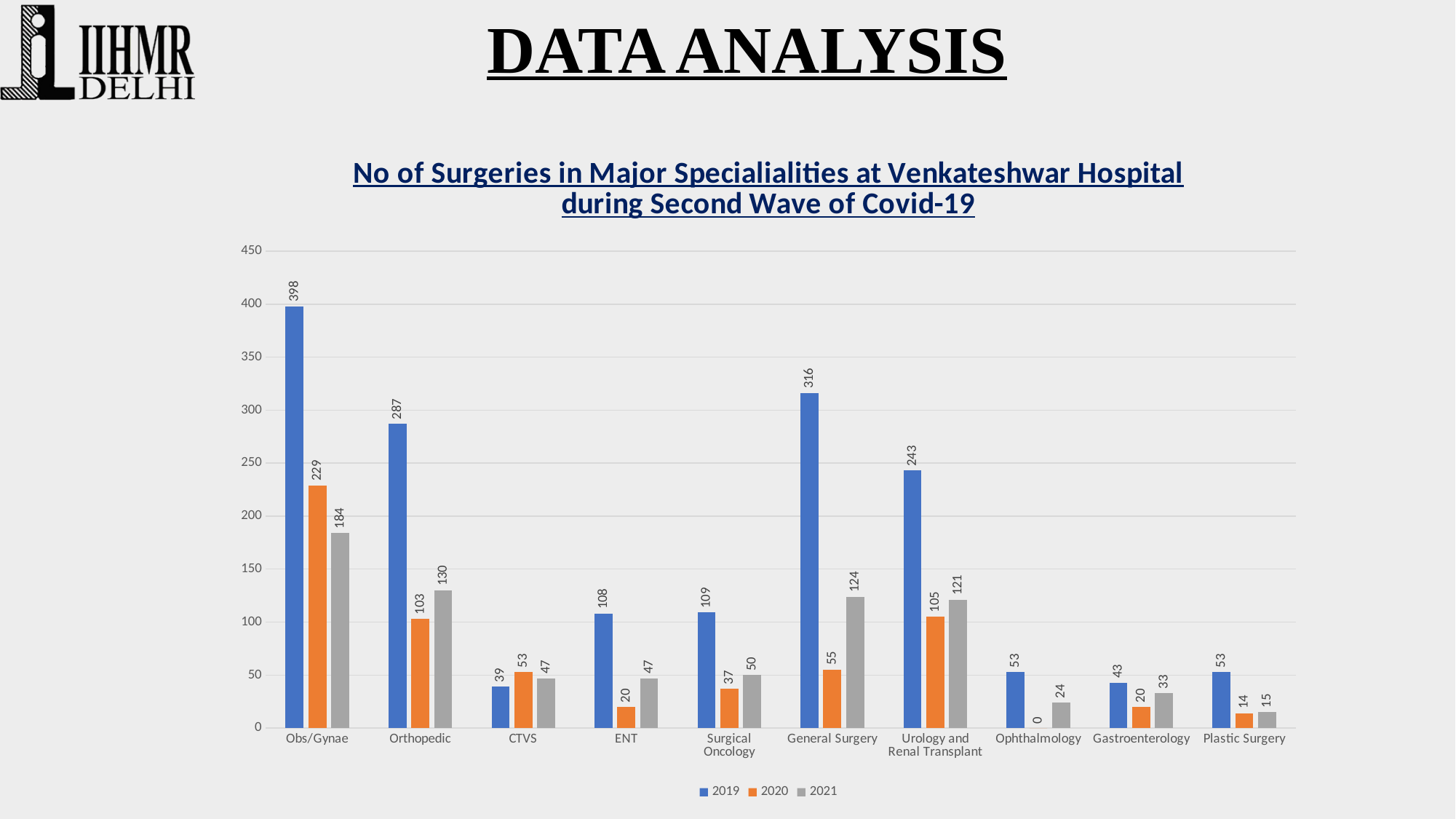
What is the number of surgeries for General Surgery in 2021? 124 Which specialty has the highest number of surgeries in 2019? Obs/Gynae How many specialties are shown on the x axis? 10 Is the value for Urology and Renal Transplant in 2019 greater or less than 200? greater Which specialty has the lowest number of surgeries in 2021? Plastic Surgery How many series does the legend list? 3 What kind of chart is shown on the slide? Bar chart Which is larger for CTVS: the 2020 value or the 2021 value? 2020 What is the number of surgeries for Obs/Gynae in 2019? 398 Which colour represents the 2020 series in the chart? Orange What is the difference between the 2019 and 2020 values for Orthopedic? 184 What is the number of surgeries for Ophthalmology in 2020? 0